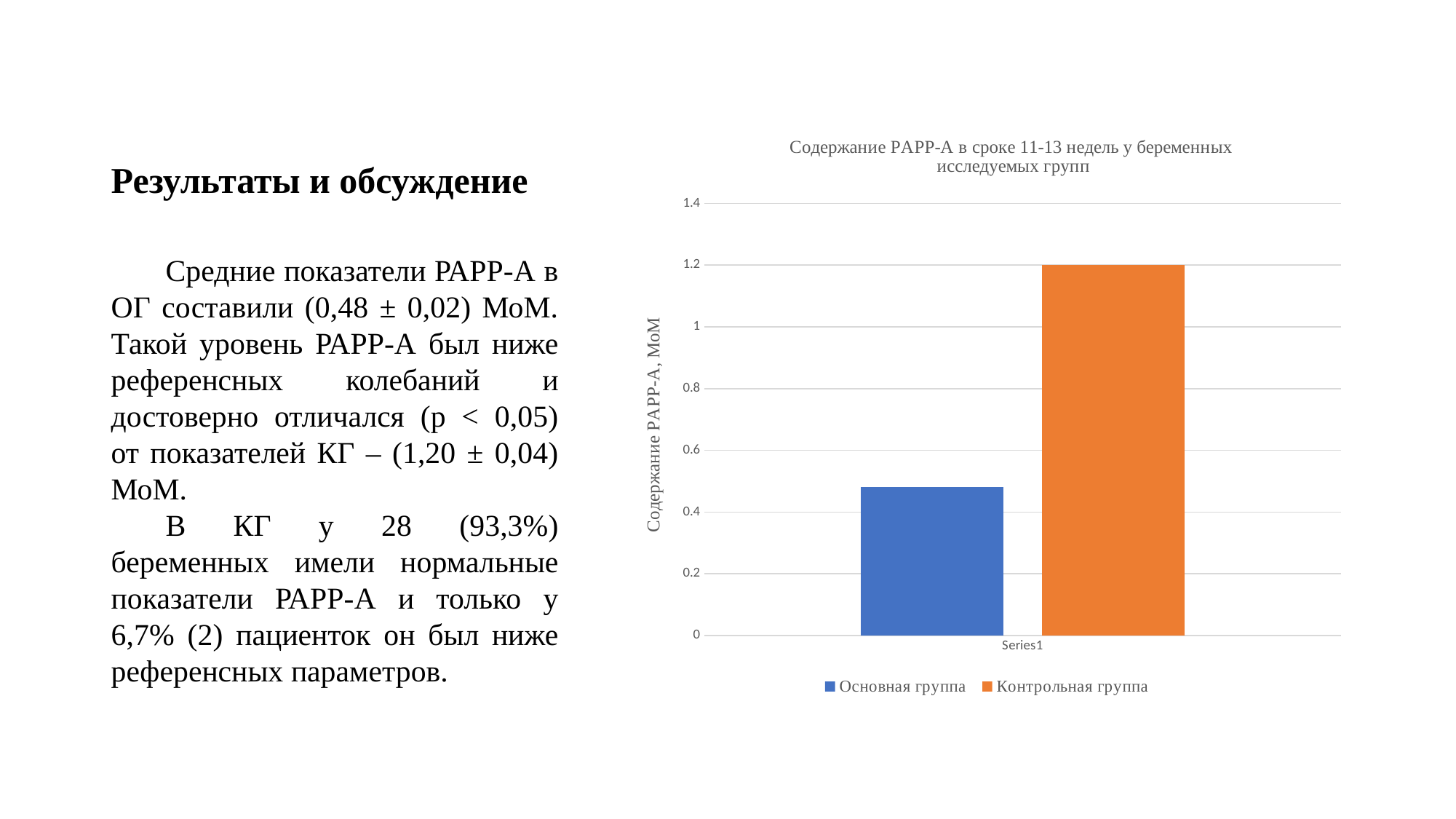
Is the value for Контрольная группа larger or smaller than the value for Основная группа? larger Which group has the higher PAPP-A value in the chart? Контрольная группа What colour is the bar for Контрольная группа? orange Is the value for Контрольная группа greater or less than 1? greater What is the value for Контрольная группа, in MoM? 1.2 How many series does the legend list? 2 What is the label of the vertical axis of the chart? Содержание PAPP-A, MoM Which group has the lower PAPP-A value in the chart? Основная группа How many categories are shown on the x axis of the chart? 1 What kind of chart is shown on the slide? bar chart Is the value for Основная группа greater or less than 0.6? less Is the value for Основная группа greater or less than 0.4? greater